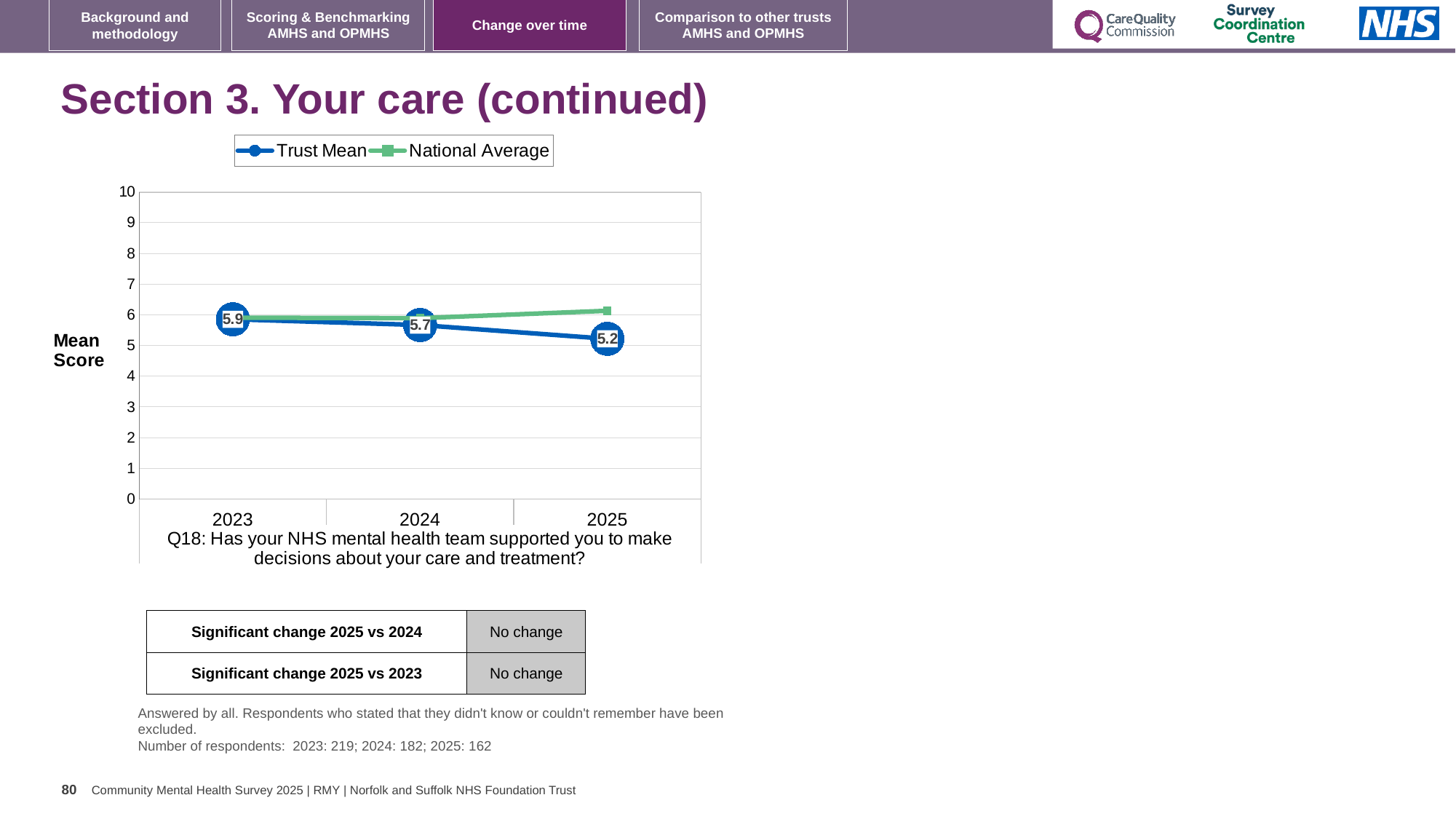
How many series does the legend list? 2 In which year is the Trust Mean score lowest? 2025 How many years are plotted on the x axis? 3 What is the Trust Mean score for 2025? 5.2 What is the Trust Mean score for 2024? 5.7 In which year is the Trust Mean score highest? 2023 Is the National Average value for 2025 greater or less than 5? greater Which is larger, the Trust Mean score in 2024 or in 2025? 2024 What kind of chart is shown on the slide? Line chart What is the Trust Mean score for 2023? 5.9 What is the difference between the Trust Mean score in 2023 and in 2025? 0.7 Does the Trust Mean score rise or fall from 2023 to 2025? Fall